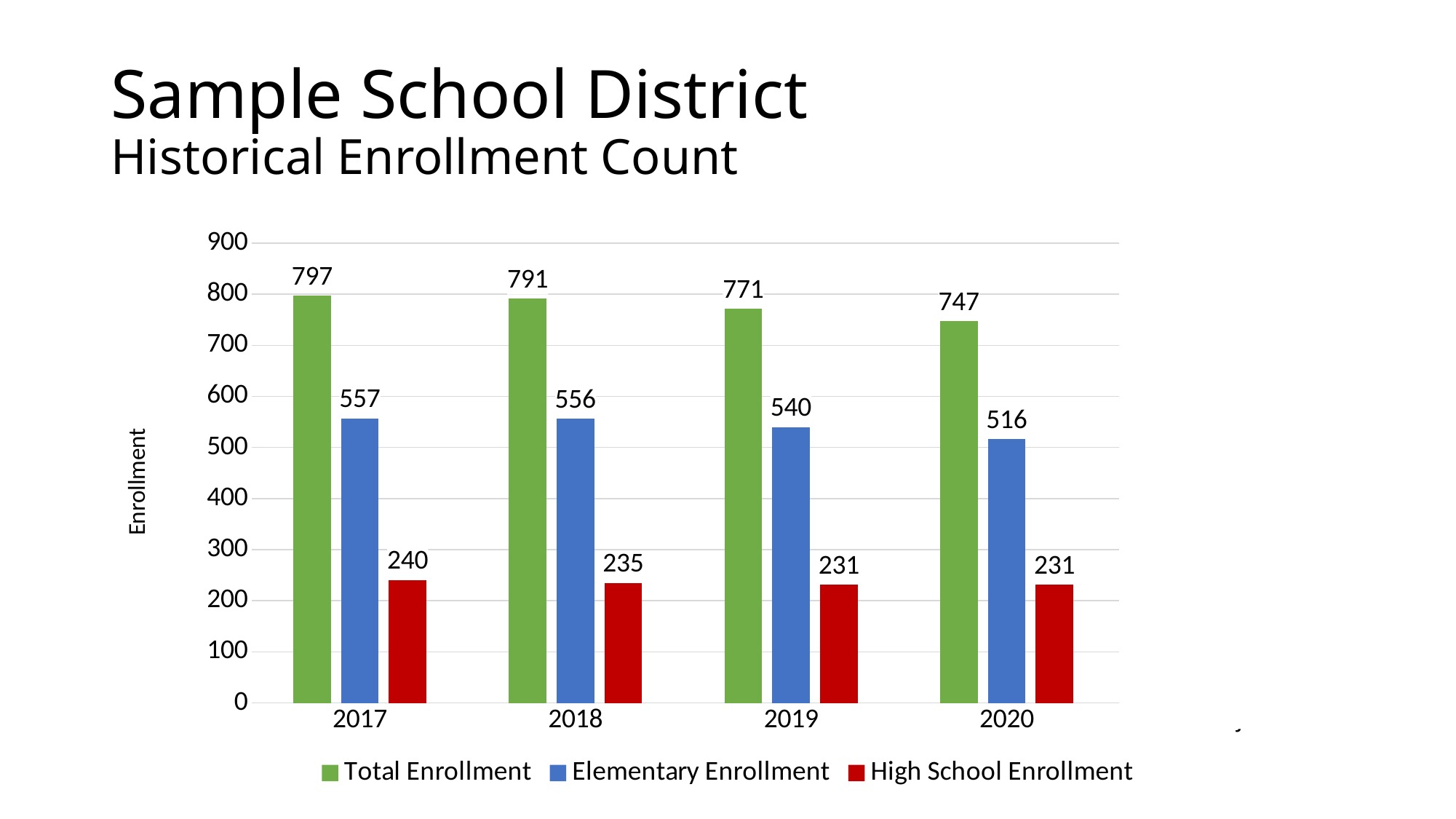
How many years are shown on the x axis? 4 What kind of chart is shown on the slide? bar chart Is the High School Enrollment value for 2017 greater or less than 300? less Which year has the highest Total Enrollment? 2017 What is the difference between Total Enrollment in 2017 and 2020? 50 What is the High School Enrollment value for 2018? 235 Does Total Enrollment rise or fall from 2017 to 2020? fall Which year has the lowest Elementary Enrollment? 2020 What is the Total Enrollment value for 2017? 797 Which is larger, Elementary Enrollment in 2018 or Elementary Enrollment in 2020? 2018 How many series does the legend list? 3 What is the Elementary Enrollment value for 2019? 540